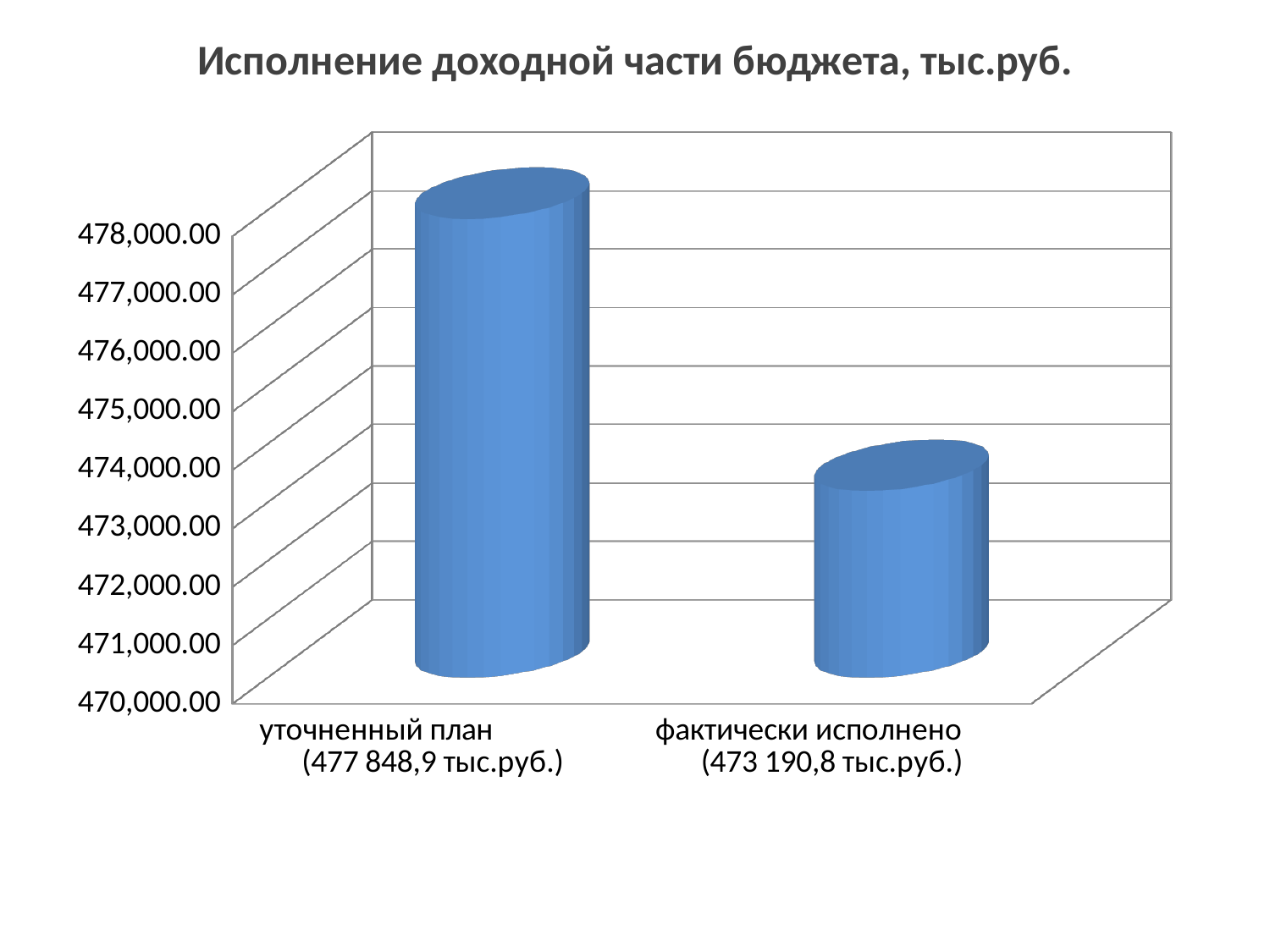
Is the value for уточненный план greater or less than 477,000.00? greater Do the values rise or fall from left to right along the x axis? fall What is the difference between уточненный план and фактически исполнено? 4 658,1 тыс.руб. Is the value for фактически исполнено greater or less than 474,000.00? less What value is given for фактически исполнено? 473 190,8 тыс.руб. What value is given for уточненный план? 477 848,9 тыс.руб. What kind of chart is shown on the slide? bar chart What is the title of the chart? Исполнение доходной части бюджета, тыс.руб. Which category has the lowest value? фактически исполнено Which category has the highest value? уточненный план How many categories are shown in the chart? 2 Which is larger, уточненный план or фактически исполнено? уточненный план